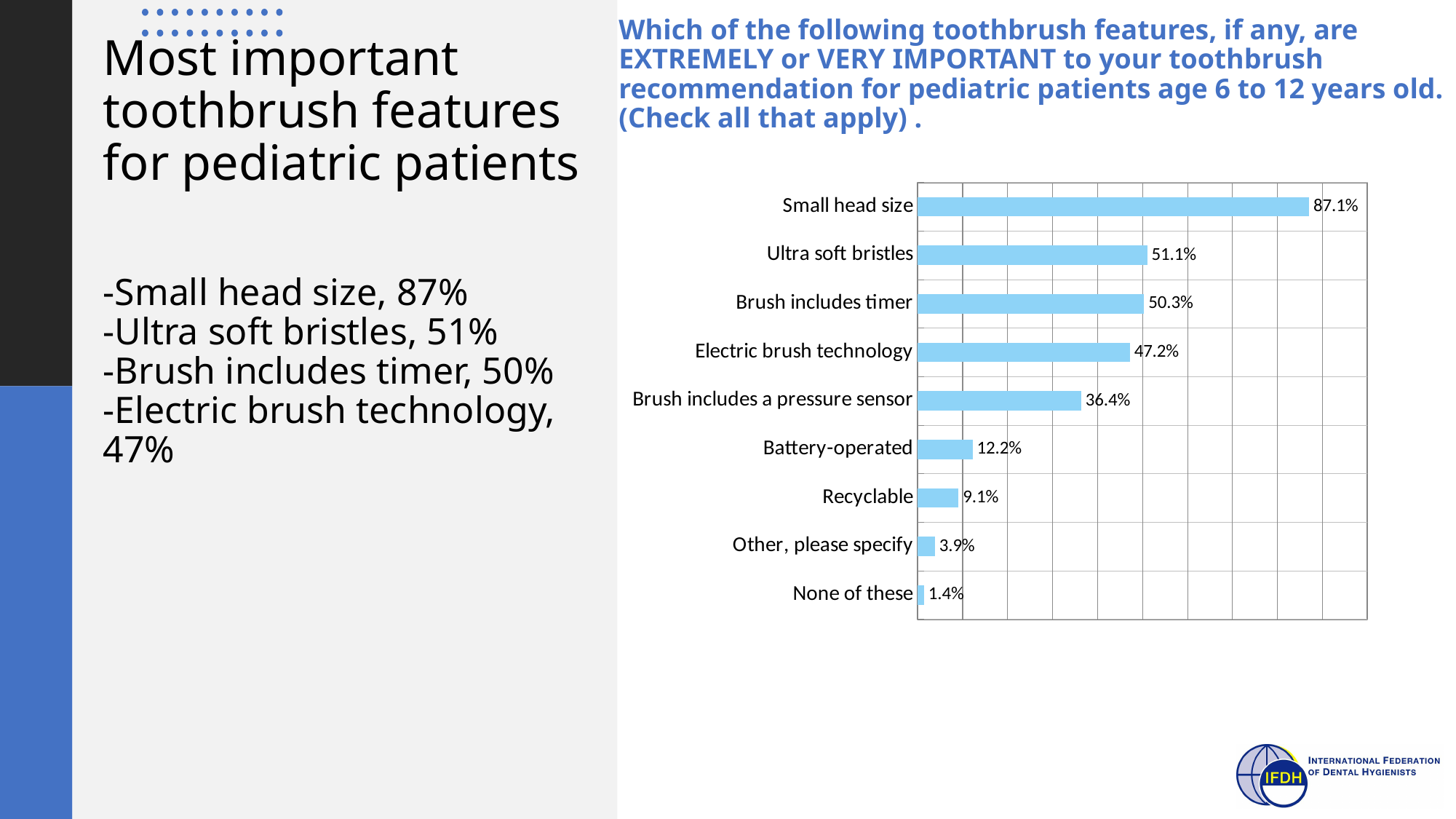
What kind of chart is shown on the slide? Bar chart How many categories are shown in the chart? 9 What is the difference between the values for Battery-operated and Recyclable? 3.1% What is the value shown for Brush includes a pressure sensor? 36.4% What colour are the bars in the chart? Light blue Which category has the lowest percentage in the chart? None of these Which has a larger value, Other, please specify or None of these? Other, please specify What percentage of respondents rated Small head size as extremely or very important? 87.1% What is the value shown for Recyclable? 9.1% Which toothbrush feature has the highest percentage in the chart? Small head size Which has a larger value, Electric brush technology or Brush includes a pressure sensor? Electric brush technology What is the difference between the values for Small head size and Ultra soft bristles? 36.0%